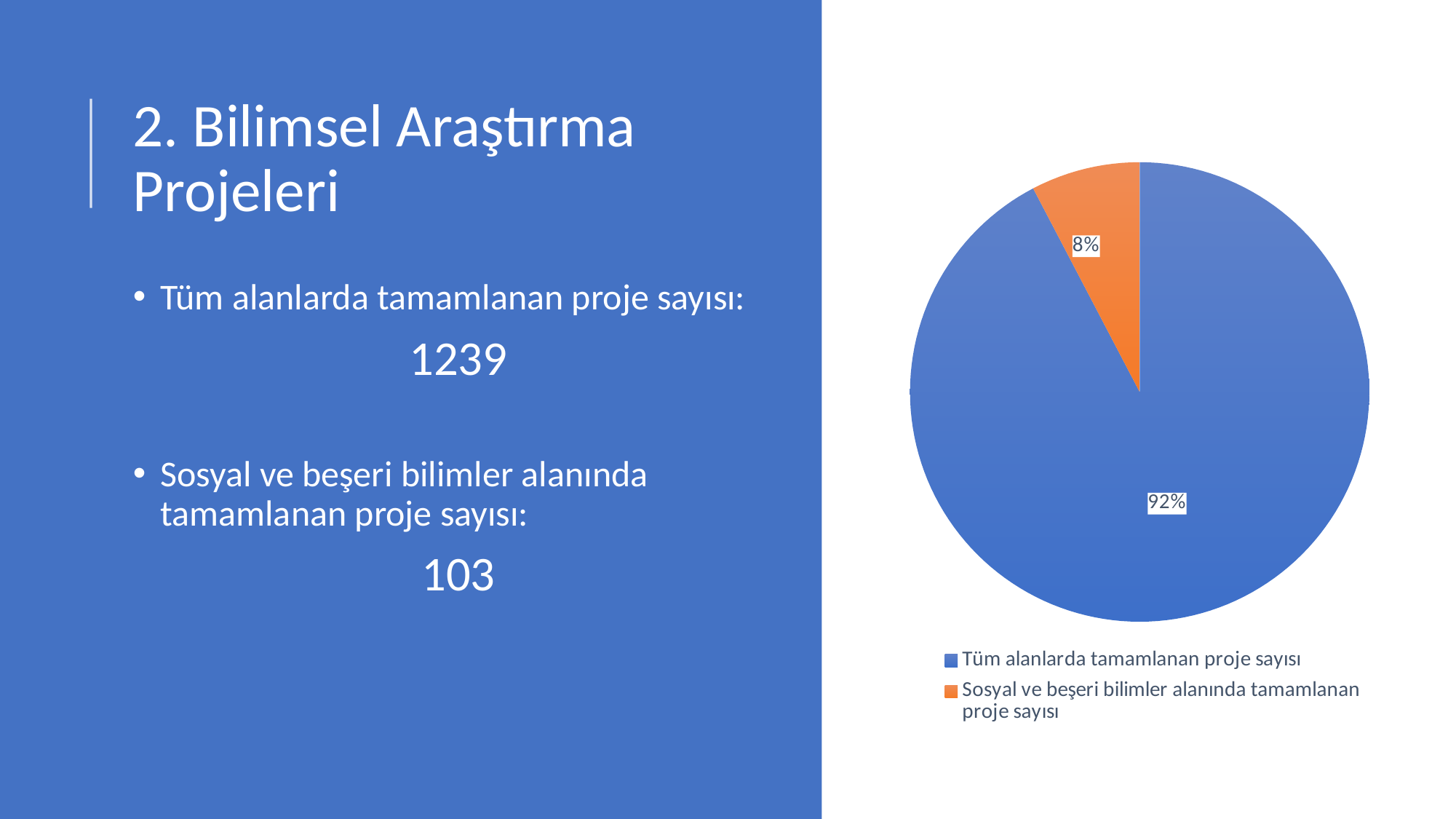
Which slice of the pie chart is the largest? Tüm alanlarda tamamlanan proje sayısı What is the difference in percentage points between the 92% slice and the 8% slice? 84 Is the share of the "Sosyal ve beşeri bilimler alanında tamamlanan proje sayısı" slice greater or less than 10%? less Which slice of the pie chart is the smallest? Sosyal ve beşeri bilimler alanında tamamlanan proje sayısı What share of the pie does the slice for "Tüm alanlarda tamamlanan proje sayısı" represent? 92% What share of the pie does the slice for "Sosyal ve beşeri bilimler alanında tamamlanan proje sayısı" represent? 8% What colour is the slice for "Tüm alanlarda tamamlanan proje sayısı"? blue What kind of chart is shown on the slide? pie chart What colour is the slice for "Sosyal ve beşeri bilimler alanında tamamlanan proje sayısı"? orange Which is larger: the slice for "Tüm alanlarda tamamlanan proje sayısı" or the slice for "Sosyal ve beşeri bilimler alanında tamamlanan proje sayısı"? Tüm alanlarda tamamlanan proje sayısı How many entries does the chart legend list? 2 How many slices does the pie chart have? 2